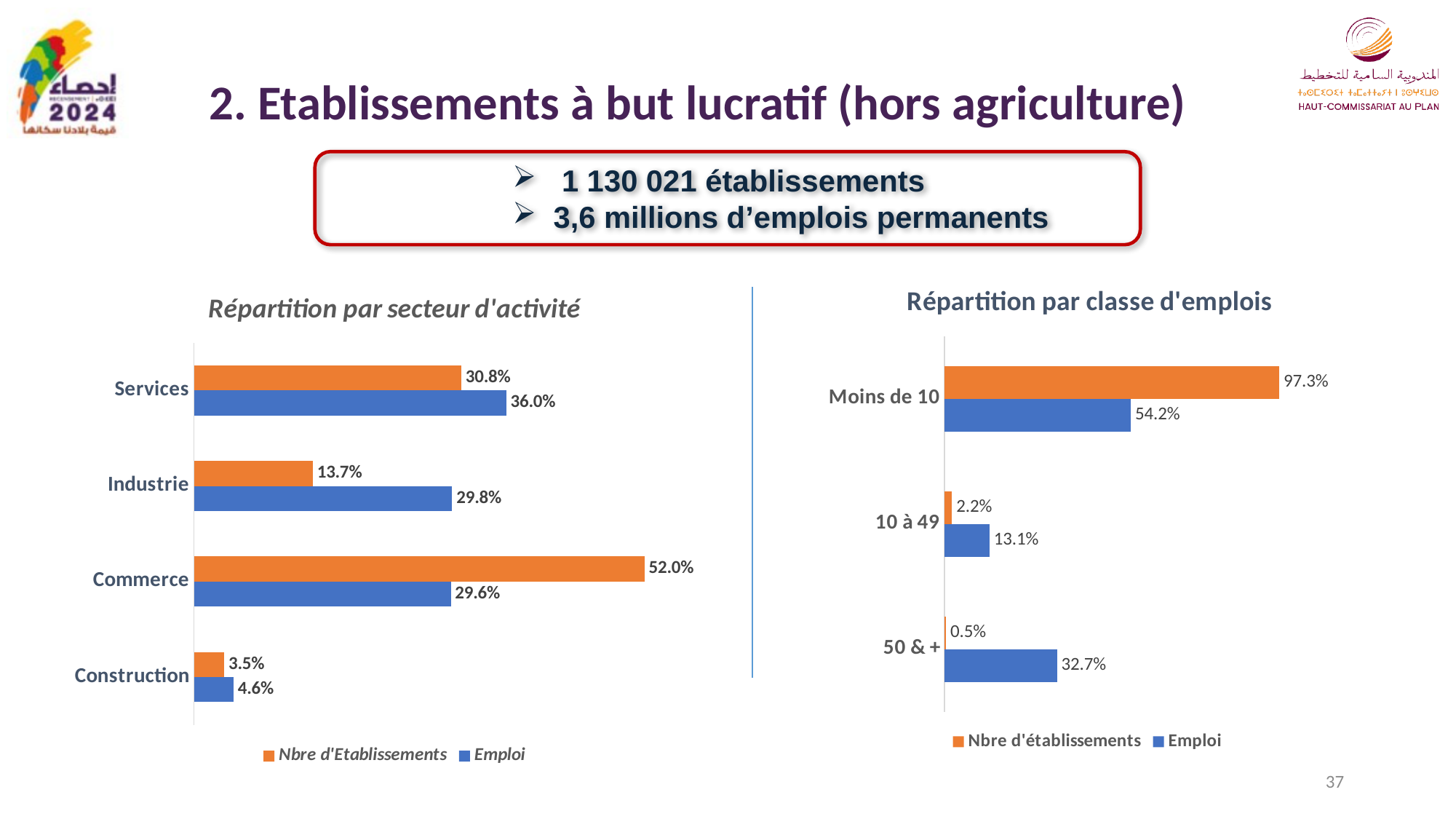
In the 'Répartition par secteur d'activité' chart, which sector has the highest Nbre d'Etablissements value? Commerce How many series does the legend of the 'Répartition par classe d'emplois' chart list? 2 In the 'Répartition par classe d'emplois' chart, what is the difference between the Nbre d'établissements value and the Emploi value for Moins de 10? 43.1% In the 'Répartition par secteur d'activité' chart, which sector has the lowest Emploi value? Construction In the 'Répartition par classe d'emplois' chart, which is larger for 10 à 49: Nbre d'établissements or Emploi? Emploi In the 'Répartition par classe d'emplois' chart, what is the Nbre d'établissements value for Moins de 10? 97.3% In the 'Répartition par secteur d'activité' chart, what is the Nbre d'Etablissements value for Commerce? 52.0% What type of chart is the 'Répartition par secteur d'activité' chart? Bar chart In the 'Répartition par classe d'emplois' chart, what is the Emploi value for 50 & +? 32.7% In the 'Répartition par secteur d'activité' chart, what is the Emploi value for Industrie? 29.8% In the 'Répartition par secteur d'activité' chart, how many sectors are shown? 4 In the 'Répartition par secteur d'activité' chart, what is the difference between the Emploi value and the Nbre d'Etablissements value for Services? 5.2%